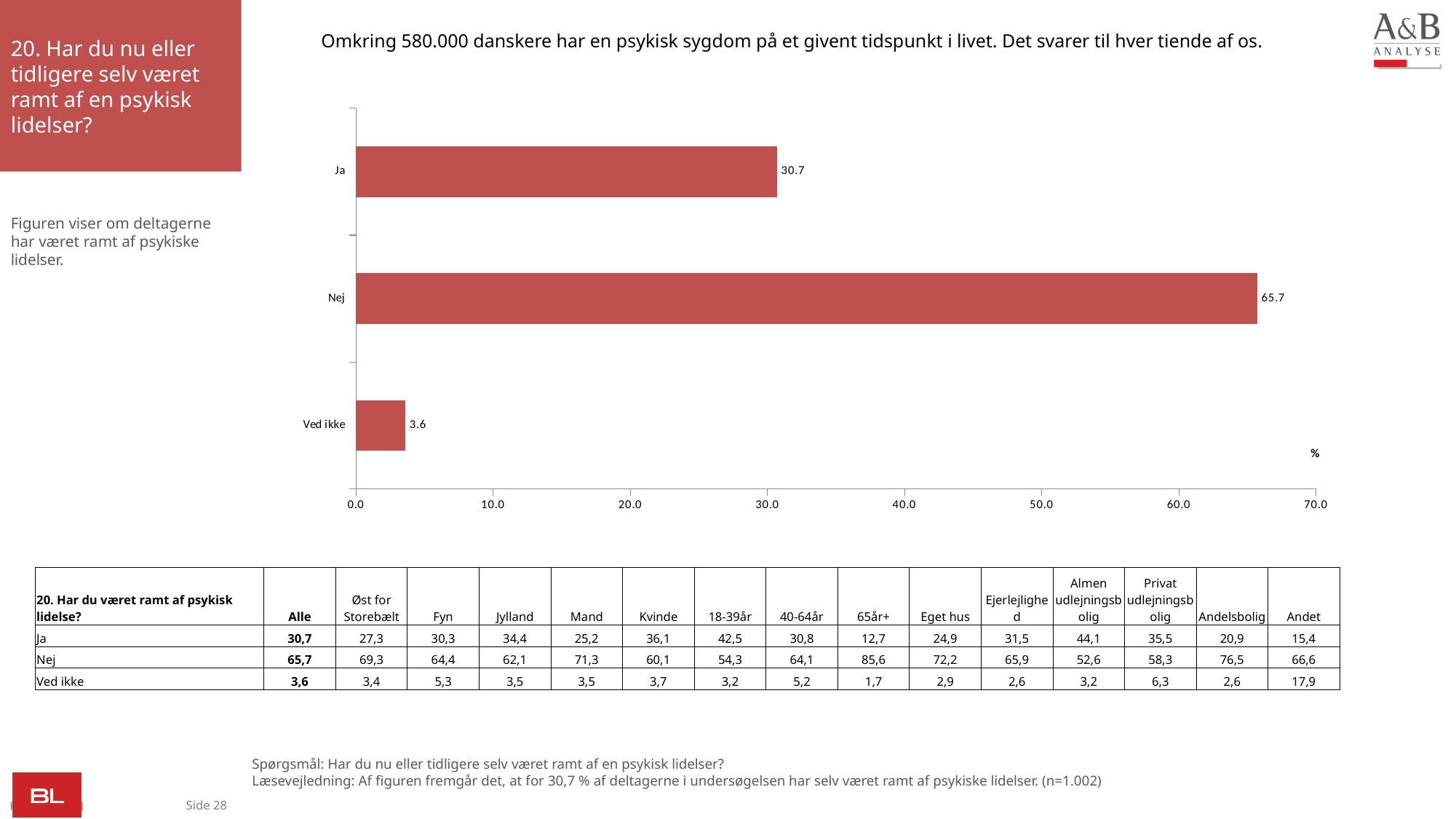
Which category has the lowest value? Ved ikke Which is larger, the value for "Ja" or the value for "Nej"? Nej Is the value for "Nej" greater or less than 60.0? greater How many categories are shown in the chart? 3 What is the value for "Nej"? 65.7 Which category has the highest value? Nej What is the value for "Ja"? 30.7 What is the maximum value shown on the x axis of the chart? 70.0 What is the difference between the values for "Ja" and "Ved ikke"? 27.1 What kind of chart is shown on the slide? bar chart What is the difference between the values for "Nej" and "Ja"? 35.0 What is the value for "Ved ikke"? 3.6